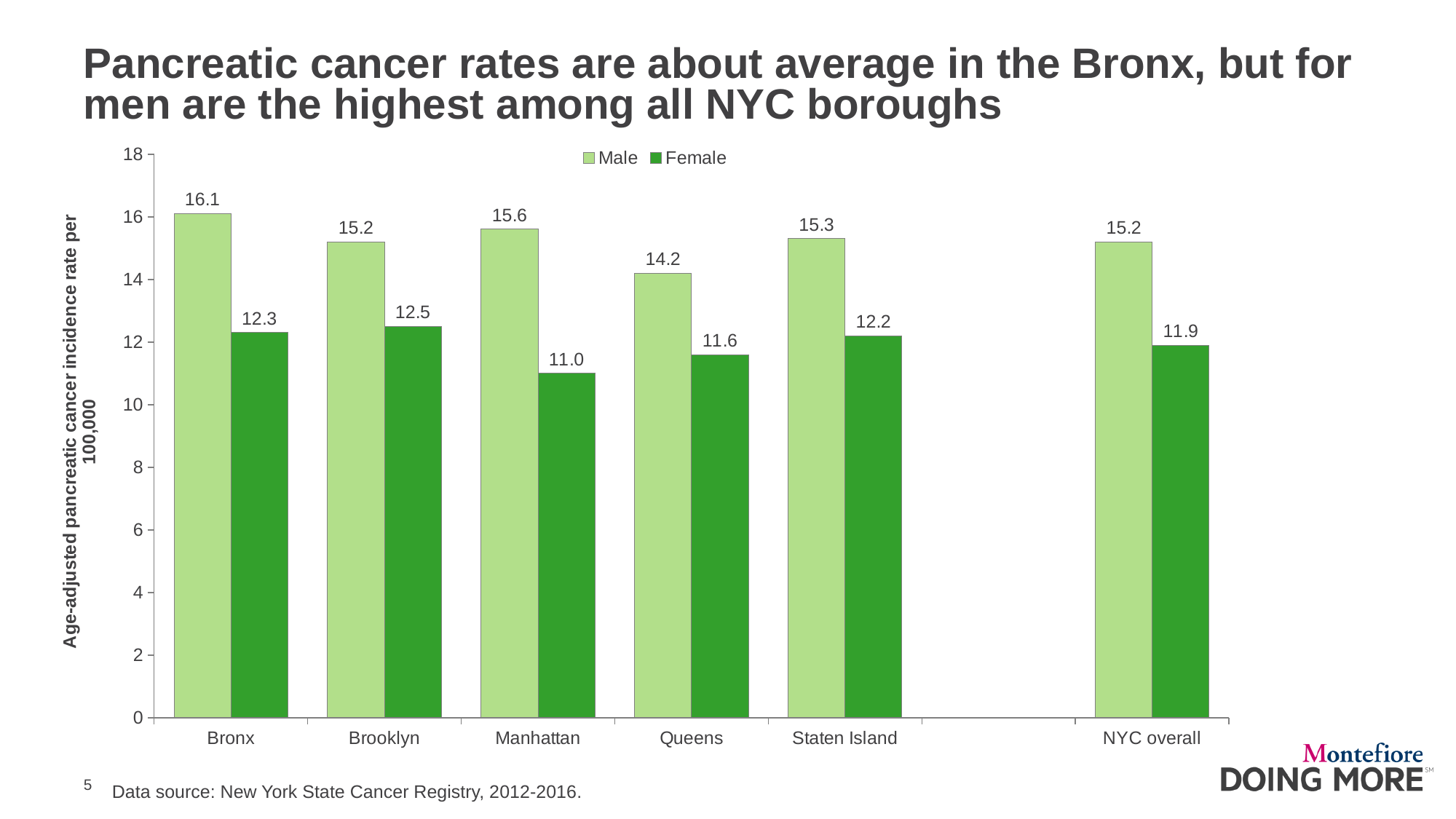
What is the Female rate for NYC overall? 11.9 Is the Female rate higher in Brooklyn or in Queens? Brooklyn What is the Female pancreatic cancer incidence rate for Manhattan? 11.0 Which category has the lowest Male rate? Queens Which category has the highest Male rate? Bronx How many categories are shown on the x axis? 6 What kind of chart is shown on the slide? Bar chart What is the label of the vertical axis? Age-adjusted pancreatic cancer incidence rate per 100,000 What is the difference between the Male and Female rates in the Bronx? 3.8 What is the Male pancreatic cancer incidence rate for the Bronx? 16.1 How many series does the legend list? 2 Which category has the lowest Female rate? Manhattan